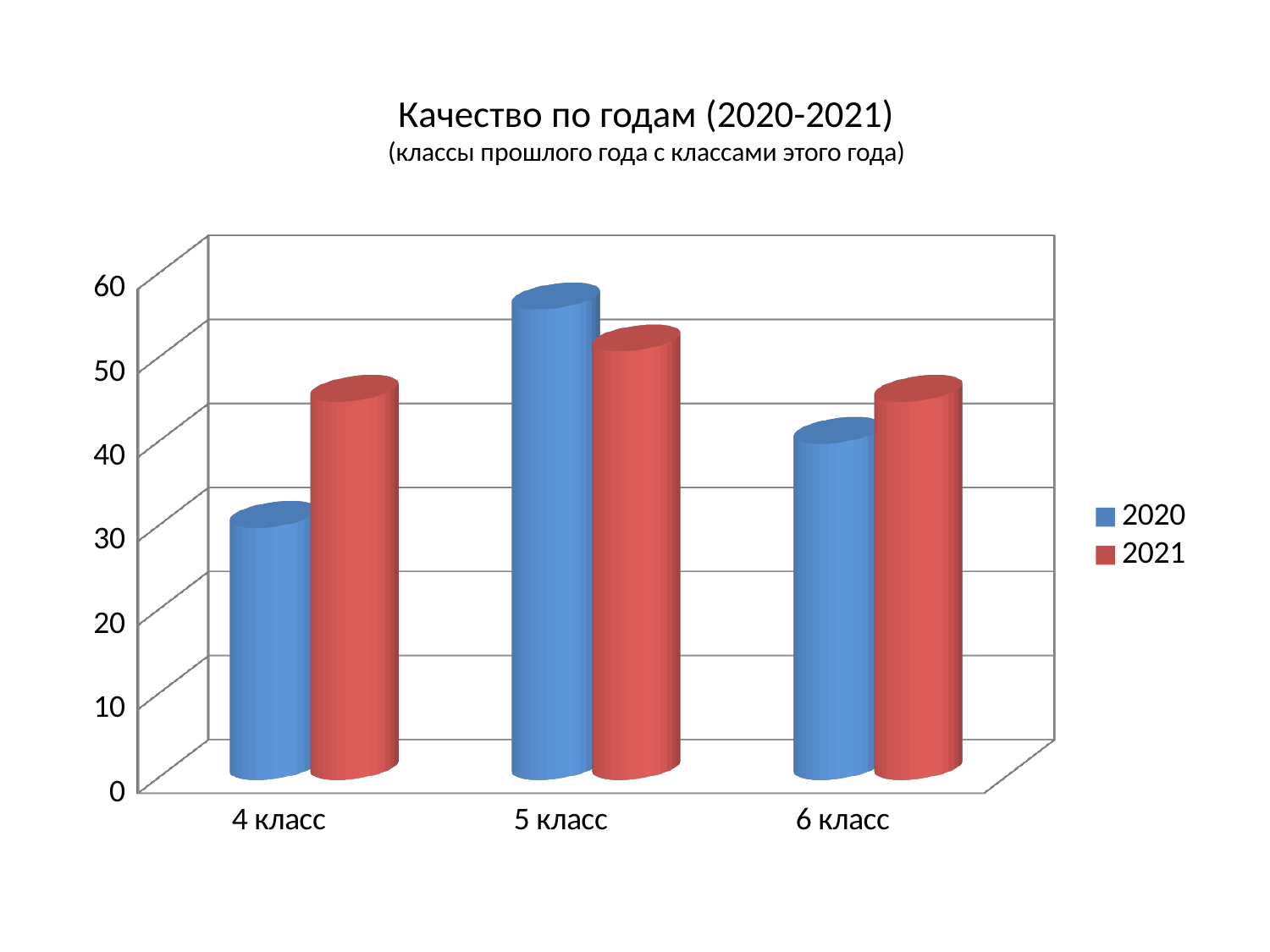
What kind of chart is shown on the slide? bar chart Is the 2020 value for 6 класс greater or less than 50? less Which colour represents the 2021 series in the legend? red Which class has the lowest value for the 2020 series? 4 класс Which class has the highest value for the 2020 series? 5 класс How many class categories are shown on the x axis? 3 For 5 класс, which series is larger, 2020 or 2021? 2020 Is the 2020 value for 5 класс greater or less than 50? greater Is the 2020 value for 4 класс greater or less than 40? less For 4 класс, which series is larger, 2020 or 2021? 2021 Which class has the highest value for the 2021 series? 5 класс How many series does the legend list? 2